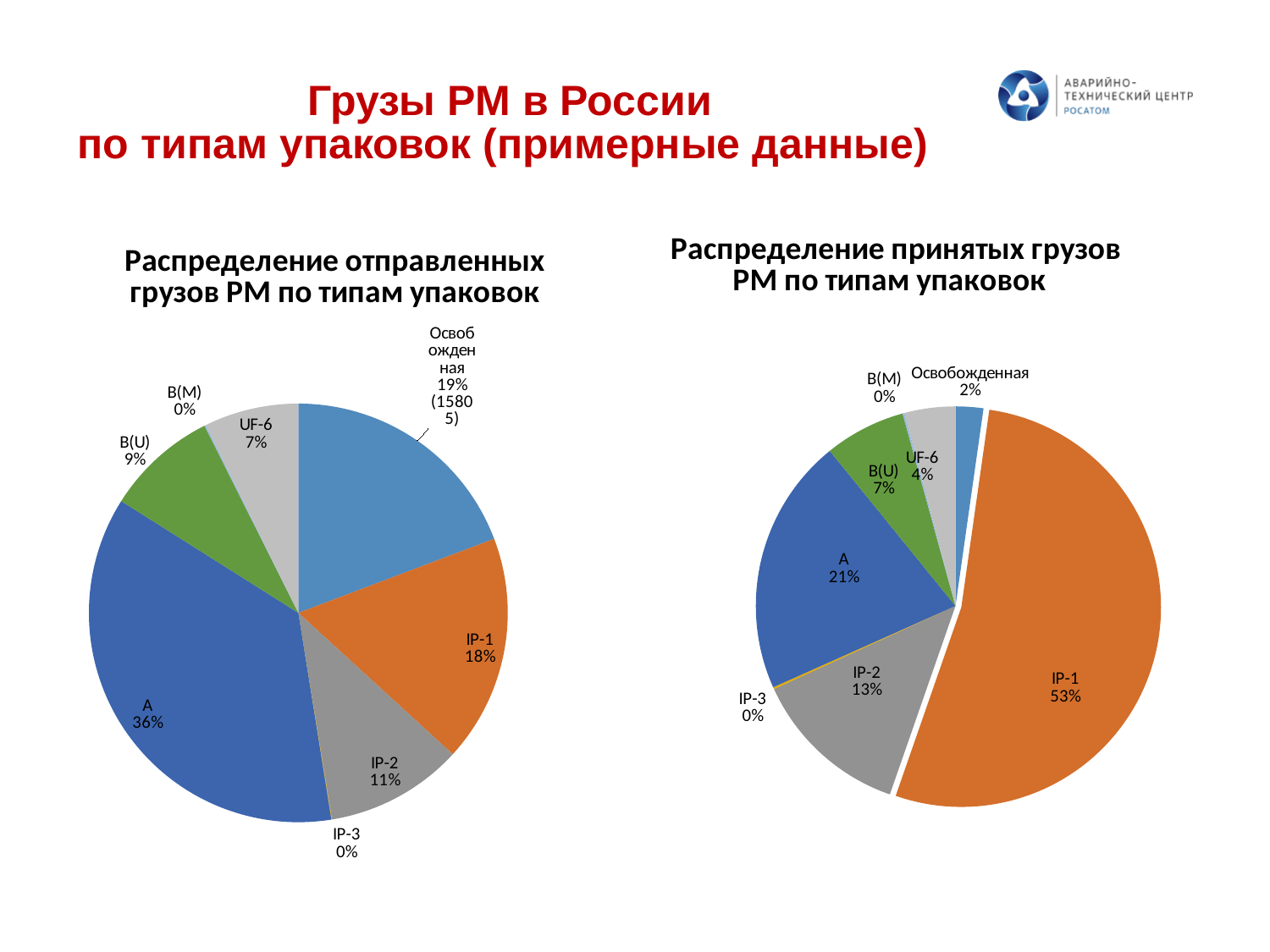
In the left chart (отправленных грузов), which category has the largest share? A In the right chart (принятых грузов), which is larger: A or IP-2? A In the right chart (принятых грузов), what share does IP-1 have? 53% What type of chart is used on the left chart, 'Распределение отправленных грузов РМ по типам упаковок'? Pie chart In the right chart (принятых грузов), which category has the largest share? IP-1 In the right chart (принятых грузов), what share does UF-6 have? 4% In the left chart (отправленных грузов), what is the difference in percentage points between A and IP-2? 25 What is the title of the right chart? Распределение принятых грузов РМ по типам упаковок In the left chart (отправленных грузов), what share does category A have? 36% In the left chart (отправленных грузов), how many categories are shown? 8 In the right chart (принятых грузов), what is the difference in percentage points between IP-1 and A? 32